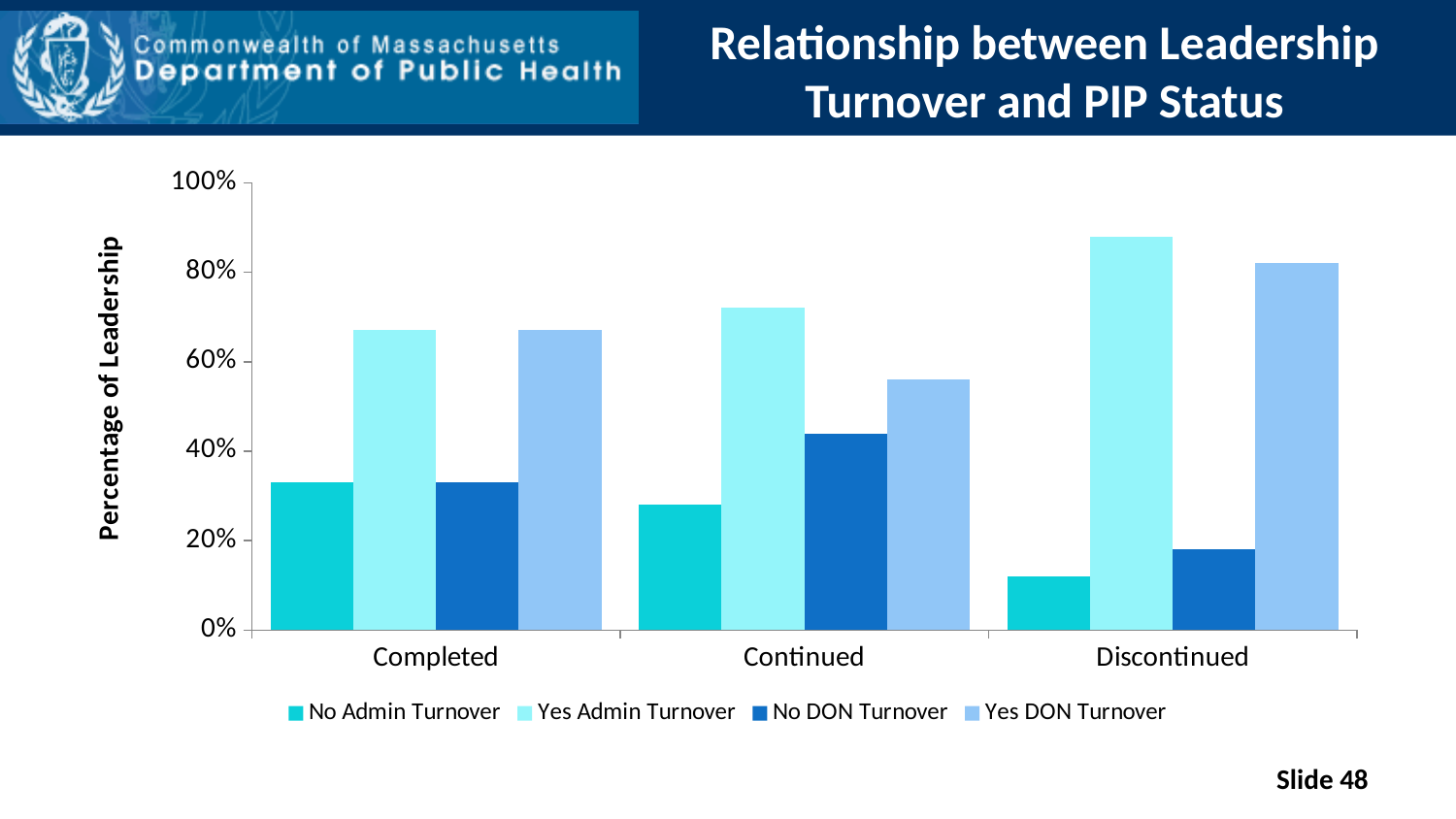
Is the value for No DON Turnover in the Completed category greater or less than 40%? less Which category has the highest value for Yes Admin Turnover? Discontinued How many series does the legend list? 4 In the Continued category, which is larger: No DON Turnover or Yes DON Turnover? Yes DON Turnover Does the value for No Admin Turnover rise or fall from Completed to Discontinued? fall Is the value for No Admin Turnover in the Discontinued category greater or less than 20%? less Which category has the lowest value for No Admin Turnover? Discontinued Is the value for Yes Admin Turnover in the Discontinued category greater or less than 80%? greater How many categories are shown on the x axis? 3 What kind of chart is shown on the slide? bar chart What is the label of the y axis? Percentage of Leadership